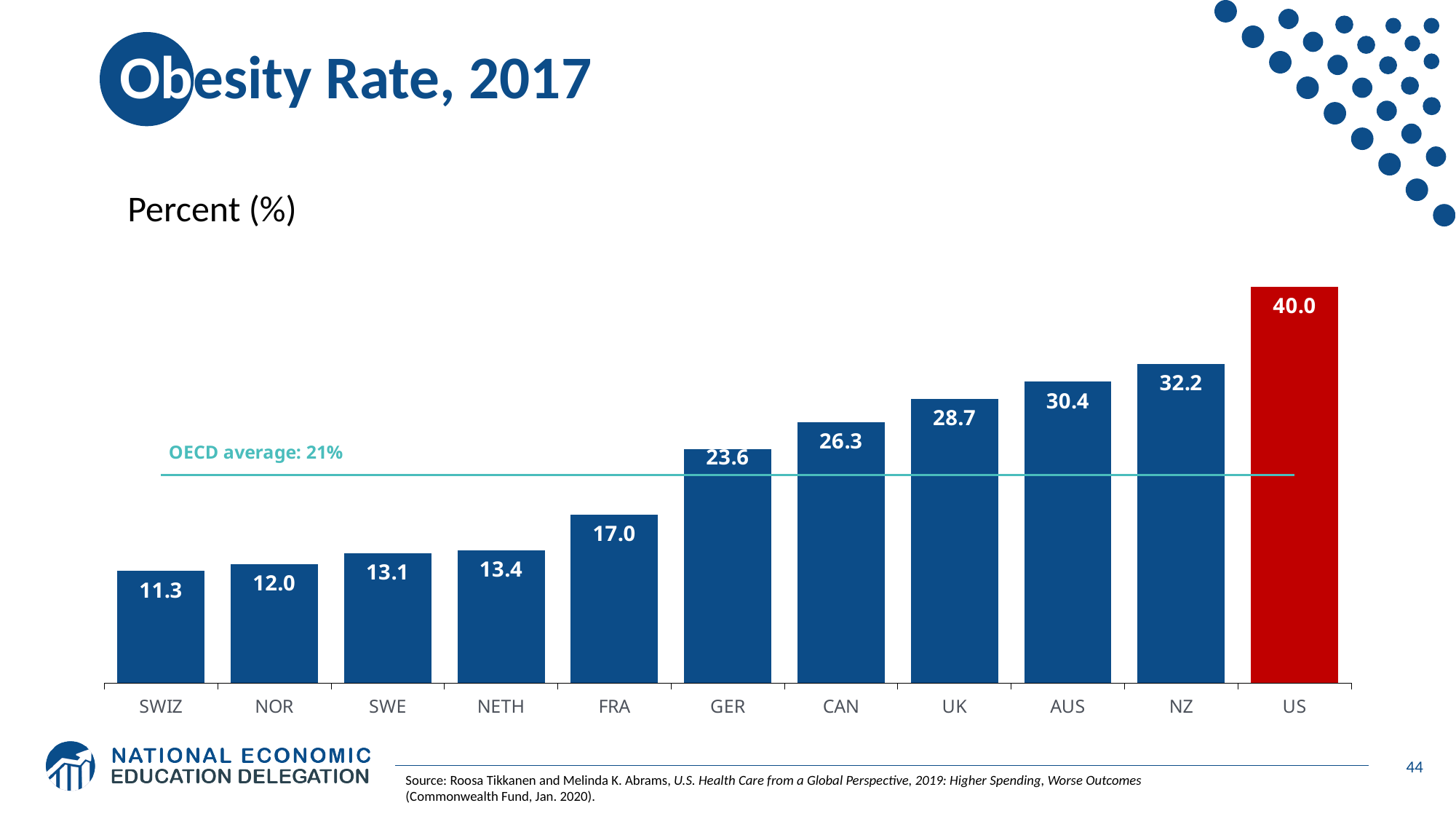
What is the obesity rate shown for Germany (GER)? 23.6 What is the difference between the obesity rates of the UK and France (FRA)? 11.7 Which country has the highest obesity rate on the chart? US What OECD average value is marked by the horizontal line on the chart? 21% How many countries are shown on the chart? 11 What is the obesity rate shown for the Netherlands (NETH)? 13.4 Which country has the lowest obesity rate on the chart? SWIZ What is the difference between the obesity rates of the US and NZ? 7.8 Do the obesity rates rise or fall moving from left to right across the chart? Rise What is the obesity rate shown for the US? 40.0 Which has a higher obesity rate, Canada (CAN) or Australia (AUS)? AUS What kind of chart is shown on the slide? Bar chart